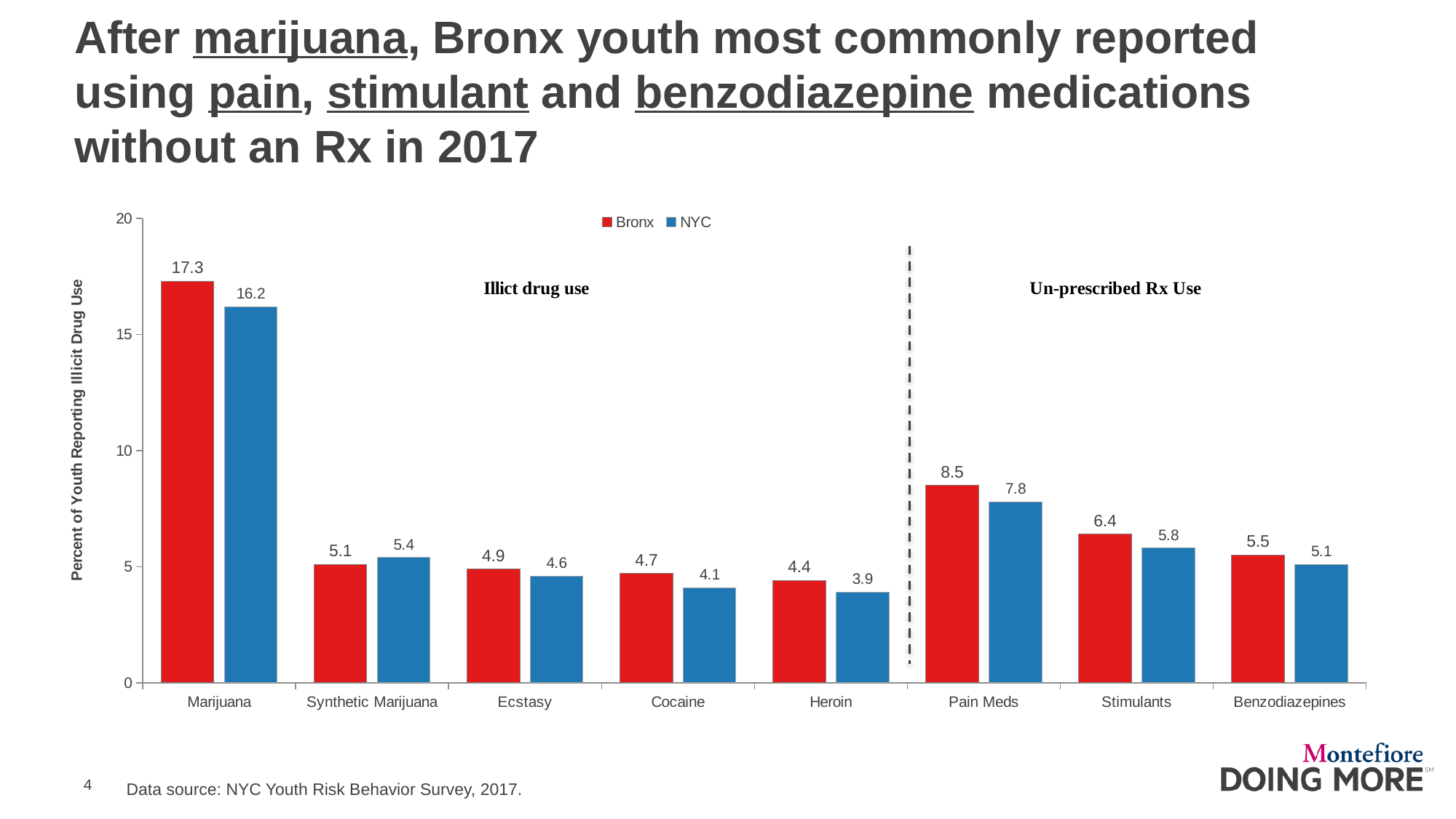
Which category has the highest NYC value? Marijuana How many series does the legend list? 2 Which category has the lowest Bronx value? Heroin Which is larger for Synthetic Marijuana, the Bronx value or the NYC value? NYC What is the difference between the Bronx and NYC values for Marijuana? 1.1 What is the difference between the Bronx values for Pain Meds and Benzodiazepines? 3.0 What is the label of the y axis? Percent of Youth Reporting Illicit Drug Use What is the Bronx value for Stimulants? 6.4 How many categories are shown on the x axis? 8 What is the NYC value for Pain Meds? 7.8 What is the Bronx value for Marijuana? 17.3 What kind of chart is shown on the slide? Bar chart